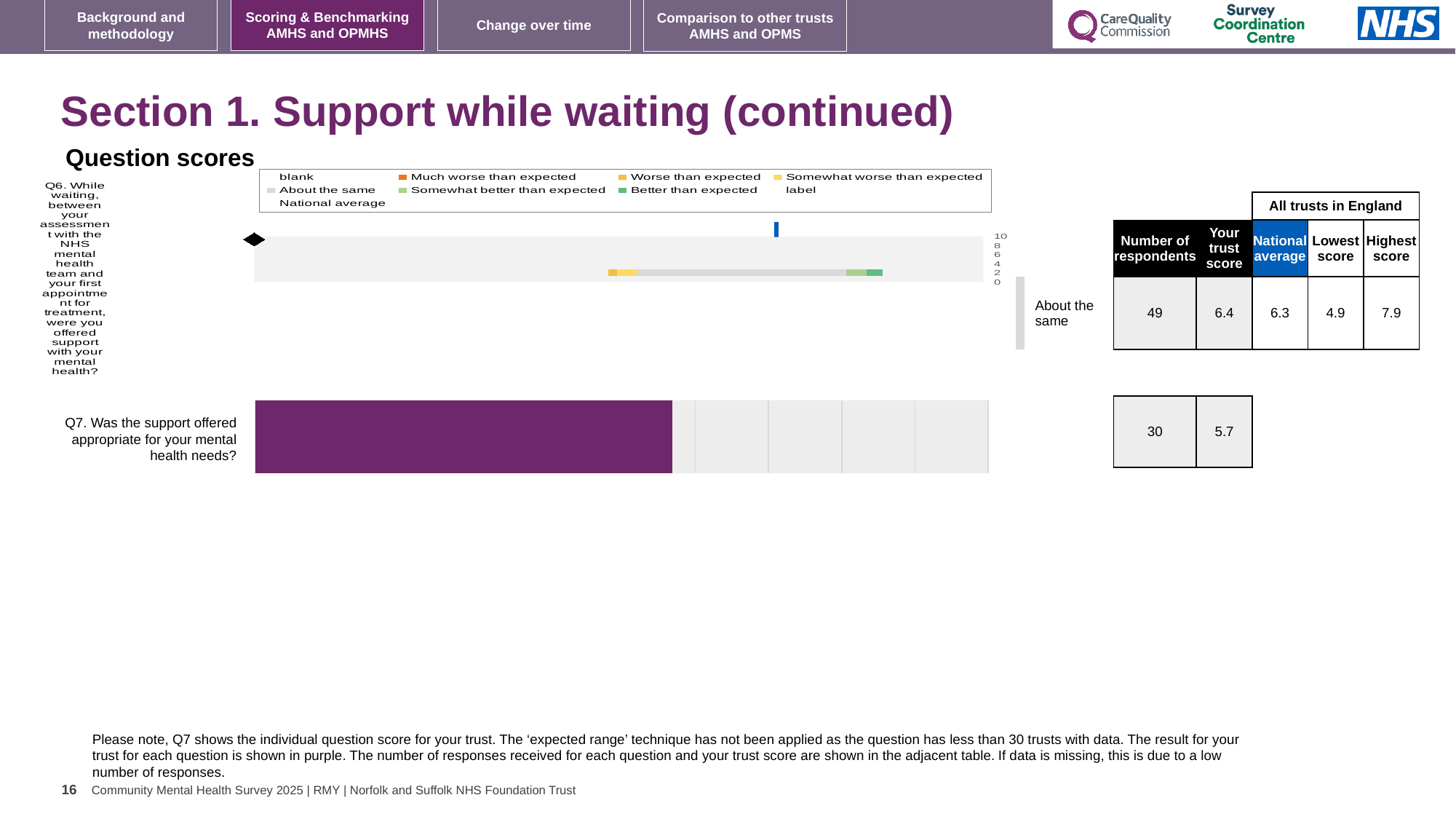
In the table next to the Q7 chart, what is the number of respondents for Q7? 30 For Q6, what is the difference between the highest score and the lowest score among all trusts in England? 3.0 What category label is shown to the right of the Q6 chart? About the same In the table next to the Q6 chart, what is the number of respondents for Q6? 49 Which question, Q6 or Q7, has more respondents? Q6 For Q6, which is larger: the trust score or the national average? Trust score (6.4) In the table next to the Q6 chart, what is the highest score among all trusts in England for Q6? 7.9 In the table next to the Q7 chart, what is the trust score for Q7? 5.7 What kind of chart is used for Q7? Bar chart In the table next to the Q6 chart, what is the trust score for Q6? 6.4 In the table next to the Q6 chart, what is the national average for Q6? 6.3 In the table next to the Q6 chart, what is the lowest score among all trusts in England for Q6? 4.9